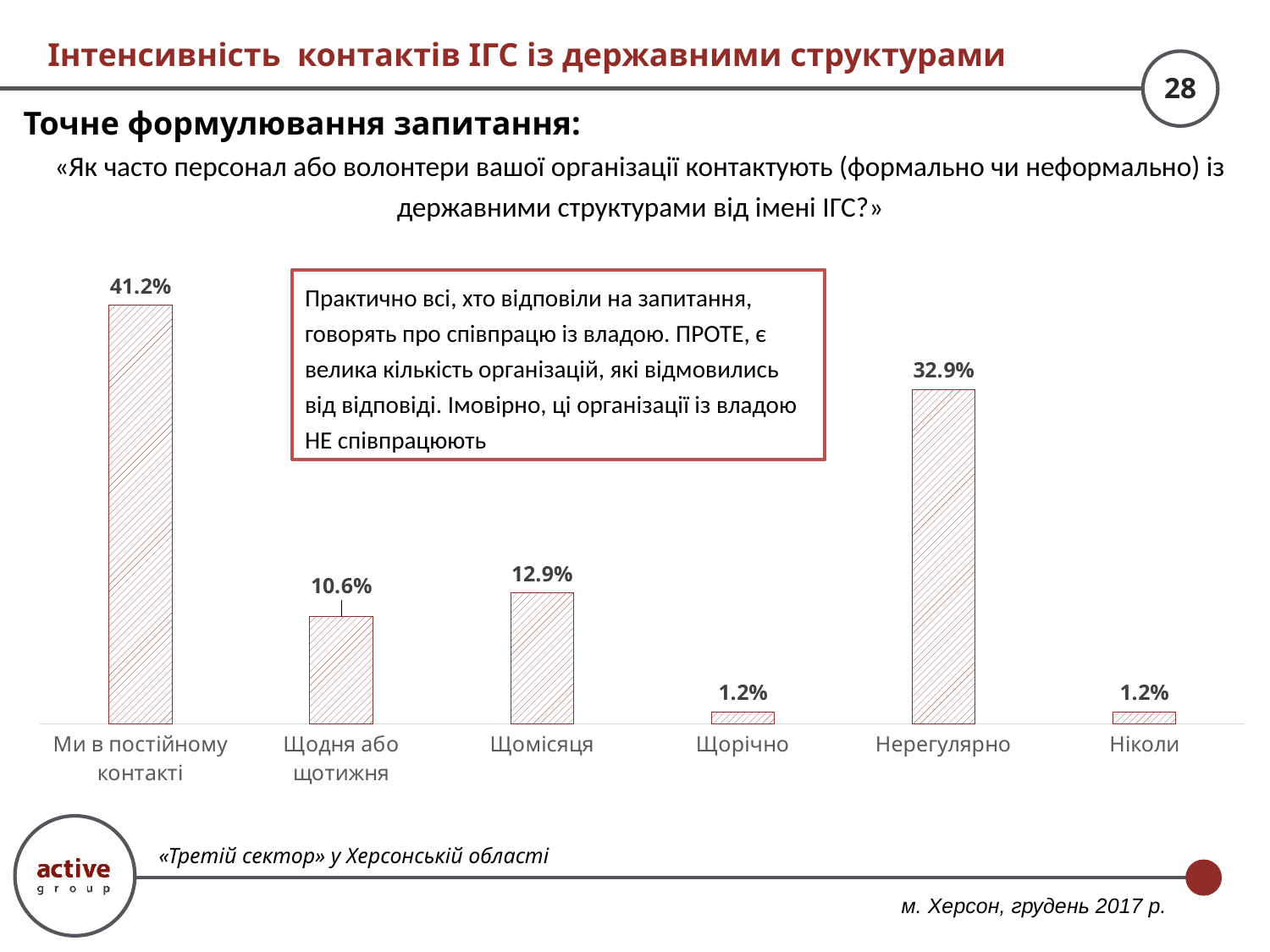
What is the value for «Нерегулярно»? 32.9% What is the difference between «Щомісяця» and «Щодня або щотижня»? 2.3% What is the combined value of «Щорічно» and «Ніколи»? 2.4% Which is larger, «Щомісяця» or «Щодня або щотижня»? Щомісяця What is the value for «Щомісяця»? 12.9% Which category has the highest value? Ми в постійному контакті What kind of chart is shown on the slide? Bar chart How many categories are shown on the chart? 6 Which two categories share the lowest value of 1.2%? Щорічно and Ніколи What is the difference between «Ми в постійному контакті» and «Нерегулярно»? 8.3% What is the value for «Щодня або щотижня»? 10.6% What is the value for «Ми в постійному контакті»? 41.2%